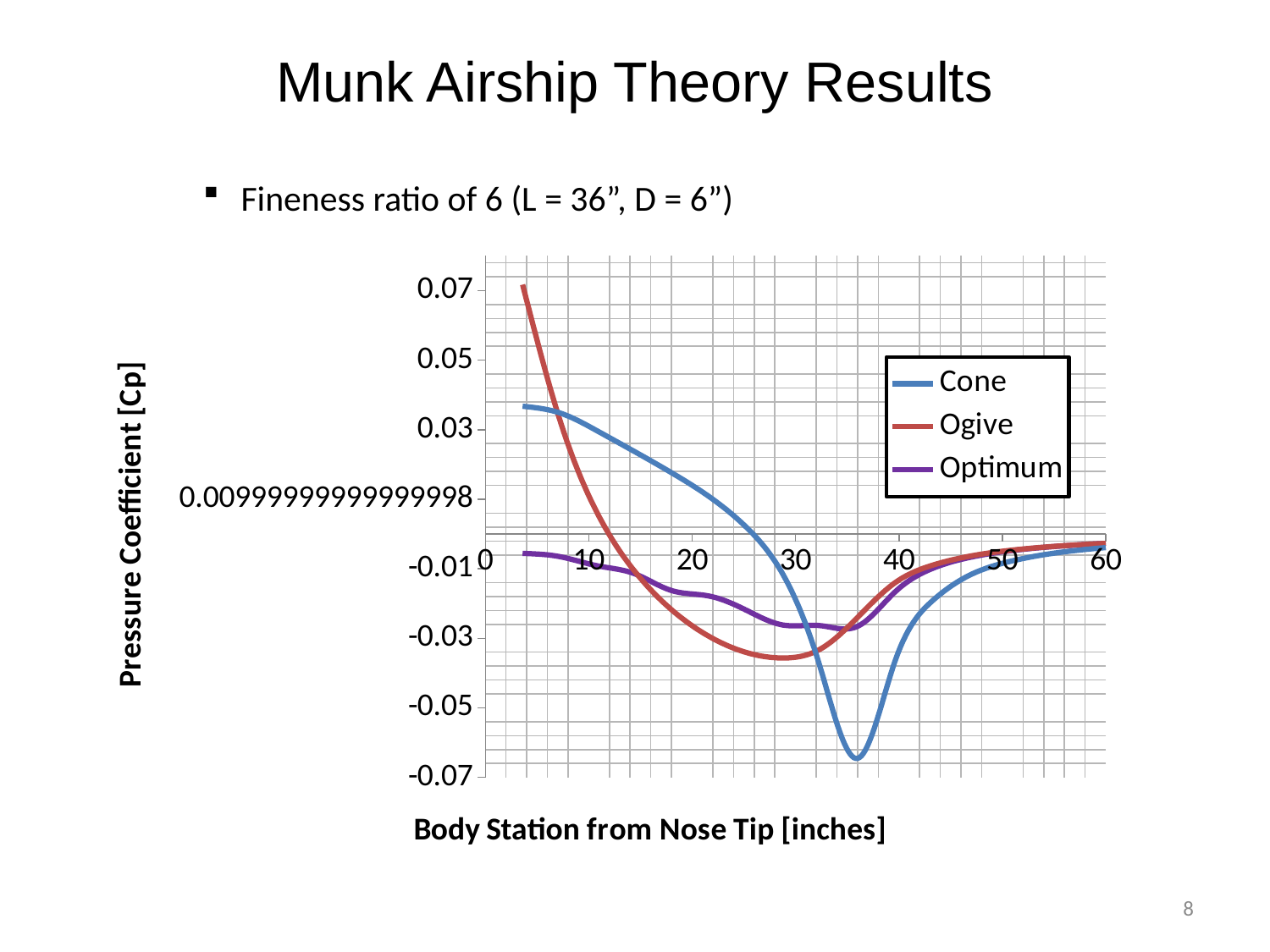
What are the names of the series listed in the legend? Cone, Ogive, Optimum What kind of chart is shown on the slide? line chart How many series does the legend list? 3 Is the minimum value of the Cone series greater or less than -0.05? less Is the value of the Ogive series at body station 0 greater or less than 0.05? greater Which series reaches the lowest pressure coefficient value on the chart? Cone What is the title of the x axis? Body Station from Nose Tip [inches] Is the minimum value of the Ogive series greater or less than -0.03? less Which series has the highest pressure coefficient at body station 0? Ogive Does the Cone series rise or fall between body station 0 and body station 30? fall At body station 20, which series has the larger pressure coefficient, Cone or Ogive? Cone